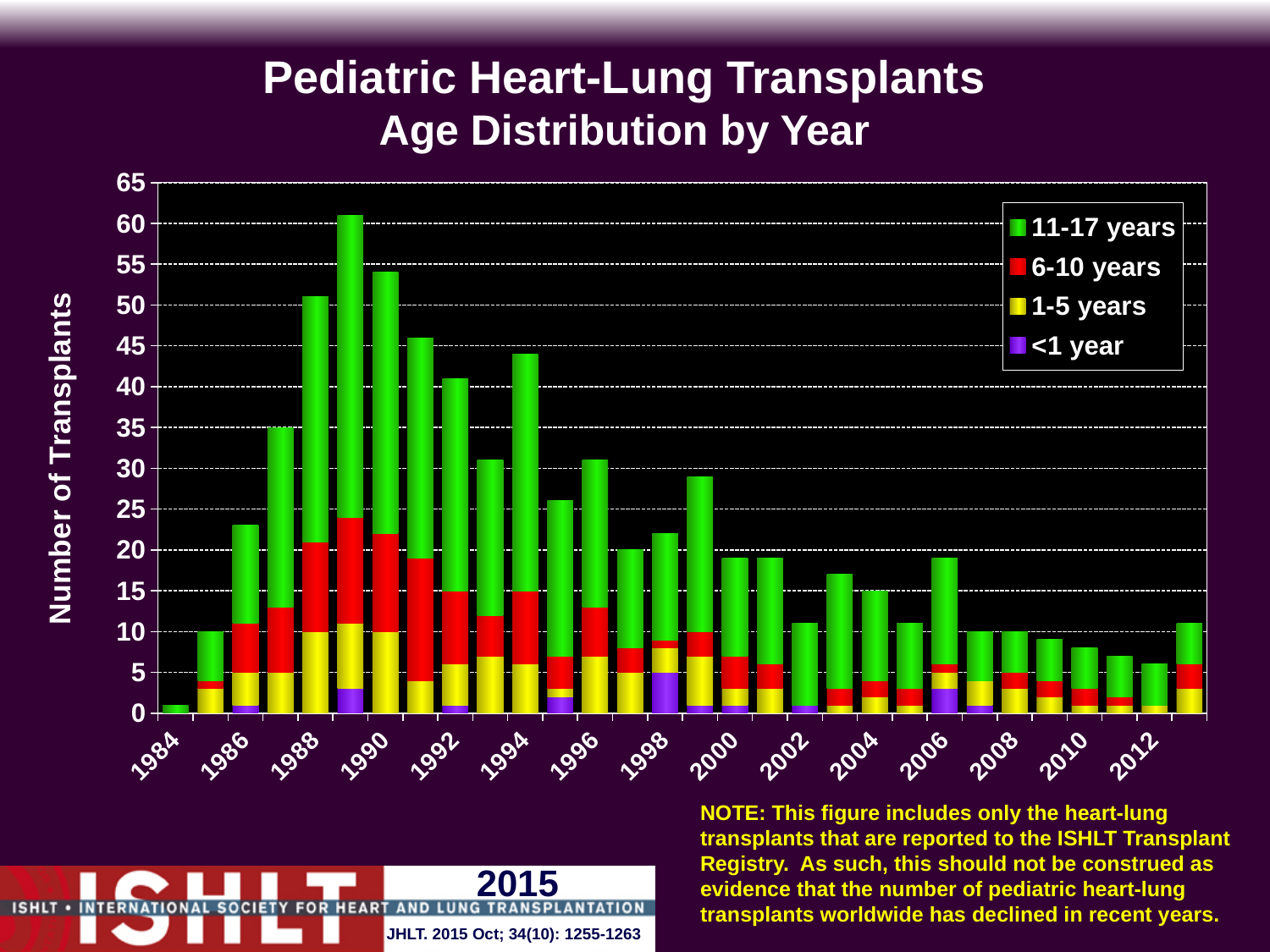
What kind of chart is shown on the slide? Stacked bar chart Is the total number of transplants in 2012 greater or less than 10? less Is the total number of transplants in 1989 greater or less than 55? greater Which year has the highest total number of pediatric heart-lung transplants? 1989 Do the total numbers of transplants generally rise or fall from 1989 to 2013? fall Which year has a higher total number of transplants, 1989 or 1990? 1989 Which year has the lowest total number of pediatric heart-lung transplants? 1984 Which year has a higher total number of transplants, 1999 or 2000? 1999 Is the total number of transplants in 1984 greater or less than 5? less How many series does the legend list? 4 Which colour represents the 11-17 years age group in the legend? Green